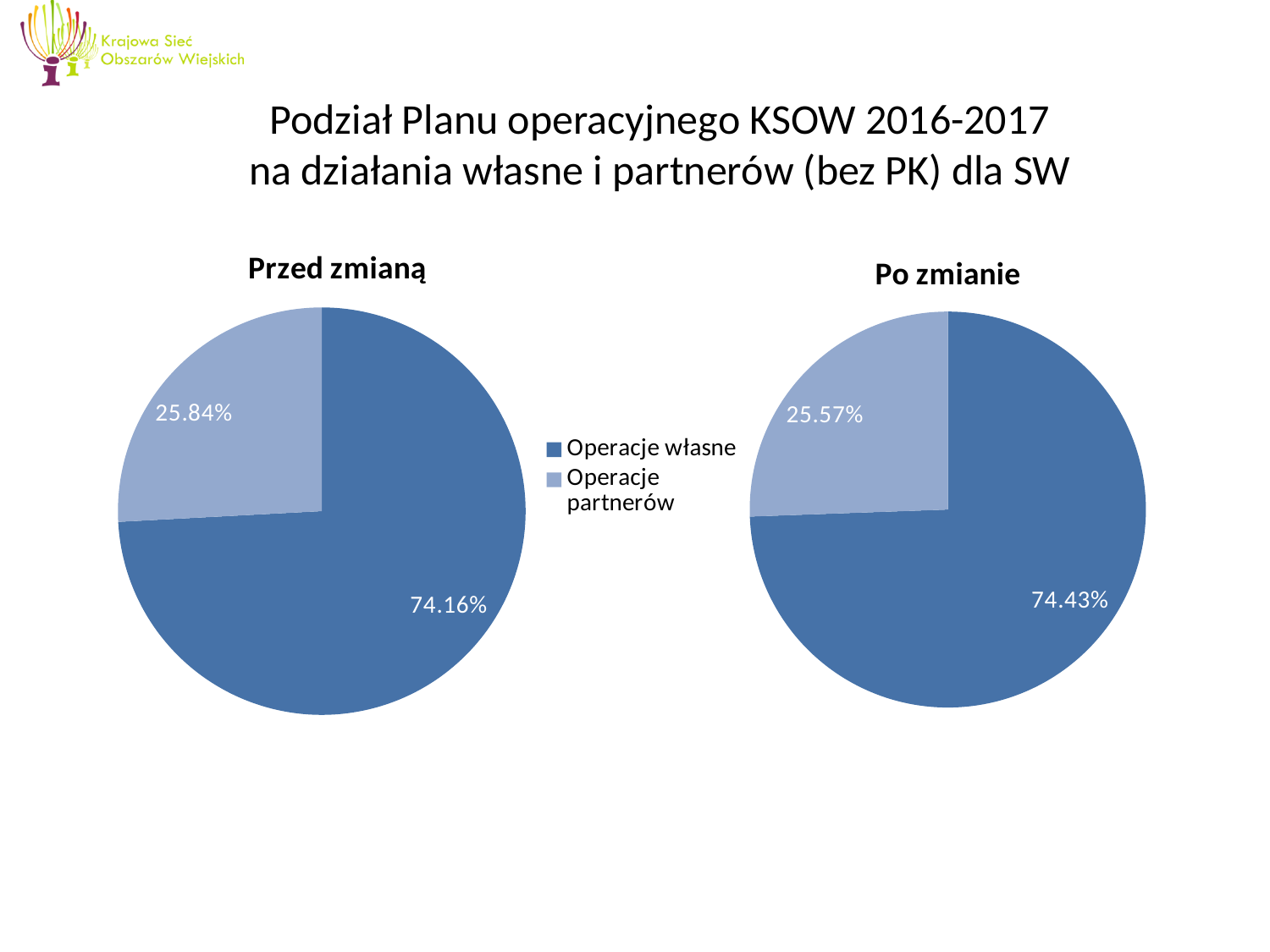
What is the title of the pie chart on the right? Po zmianie In the 'Przed zmianą' pie chart, what share does Operacje własne have? 74.16% In the 'Po zmianie' pie chart, what share does Operacje własne have? 74.43% How many slices does the 'Po zmianie' pie chart have? 2 In the 'Po zmianie' pie chart, which category has the smallest slice? Operacje partnerów In the 'Przed zmianą' pie chart, which category has the largest slice? Operacje własne In the 'Przed zmianą' pie chart, what share does Operacje partnerów have? 25.84% How many entries does the legend list? 2 In the 'Przed zmianą' pie chart, what is the difference between the Operacje własne and Operacje partnerów shares? 48.32% In the 'Po zmianie' pie chart, what share does Operacje partnerów have? 25.57% Which is larger: the Operacje partnerów share in 'Przed zmianą' or in 'Po zmianie'? Przed zmianą What kind of chart is used on this slide? Pie chart